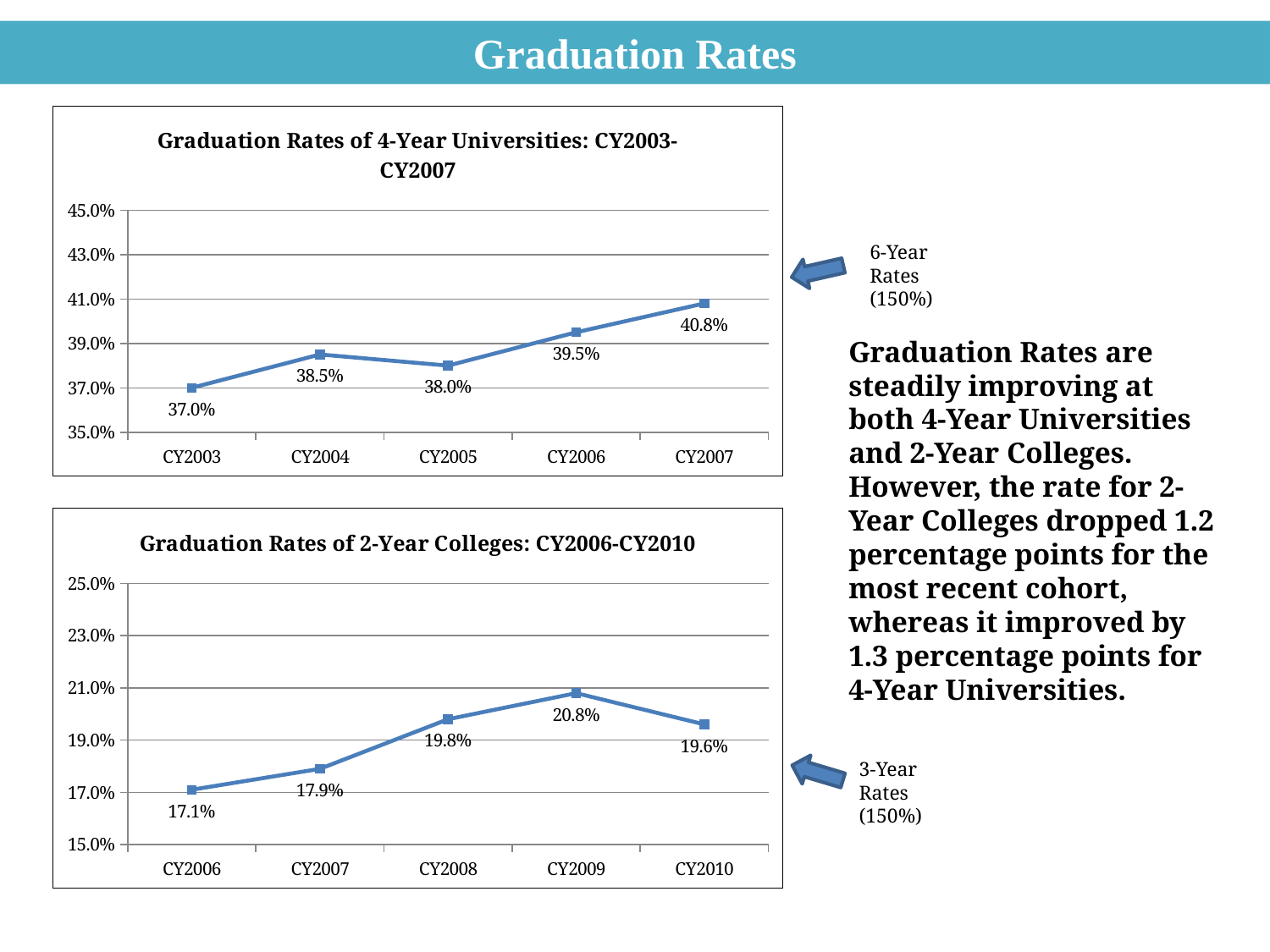
In the 'Graduation Rates of 2-Year Colleges: CY2006-CY2010' chart, how much did the rate drop from CY2009 to CY2010? 1.2 percentage points In the 'Graduation Rates of 2-Year Colleges: CY2006-CY2010' chart, which year has the highest graduation rate? CY2009 In the 'Graduation Rates of 2-Year Colleges: CY2006-CY2010' chart, what is the graduation rate for CY2008? 19.8% In the 'Graduation Rates of 2-Year Colleges: CY2006-CY2010' chart, which year has the lowest graduation rate? CY2006 In the 'Graduation Rates of 4-Year Universities: CY2003-CY2007' chart, which year has the highest graduation rate? CY2007 In the 'Graduation Rates of 4-Year Universities: CY2003-CY2007' chart, which is larger, the rate for CY2004 or CY2005? CY2004 In the 'Graduation Rates of 4-Year Universities: CY2003-CY2007' chart, what is the graduation rate for CY2005? 38.0% How many data points are plotted in the 'Graduation Rates of 4-Year Universities: CY2003-CY2007' chart? 5 What type of chart is the 'Graduation Rates of 2-Year Colleges: CY2006-CY2010' chart? Line chart In the 'Graduation Rates of 4-Year Universities: CY2003-CY2007' chart, what is the difference between the CY2007 and CY2003 graduation rates? 3.8 percentage points In the 'Graduation Rates of 2-Year Colleges: CY2006-CY2010' chart, is the value for CY2009 greater or less than 21.0%? less In the 'Graduation Rates of 4-Year Universities: CY2003-CY2007' chart, do the values generally rise or fall from CY2003 to CY2007? Rise